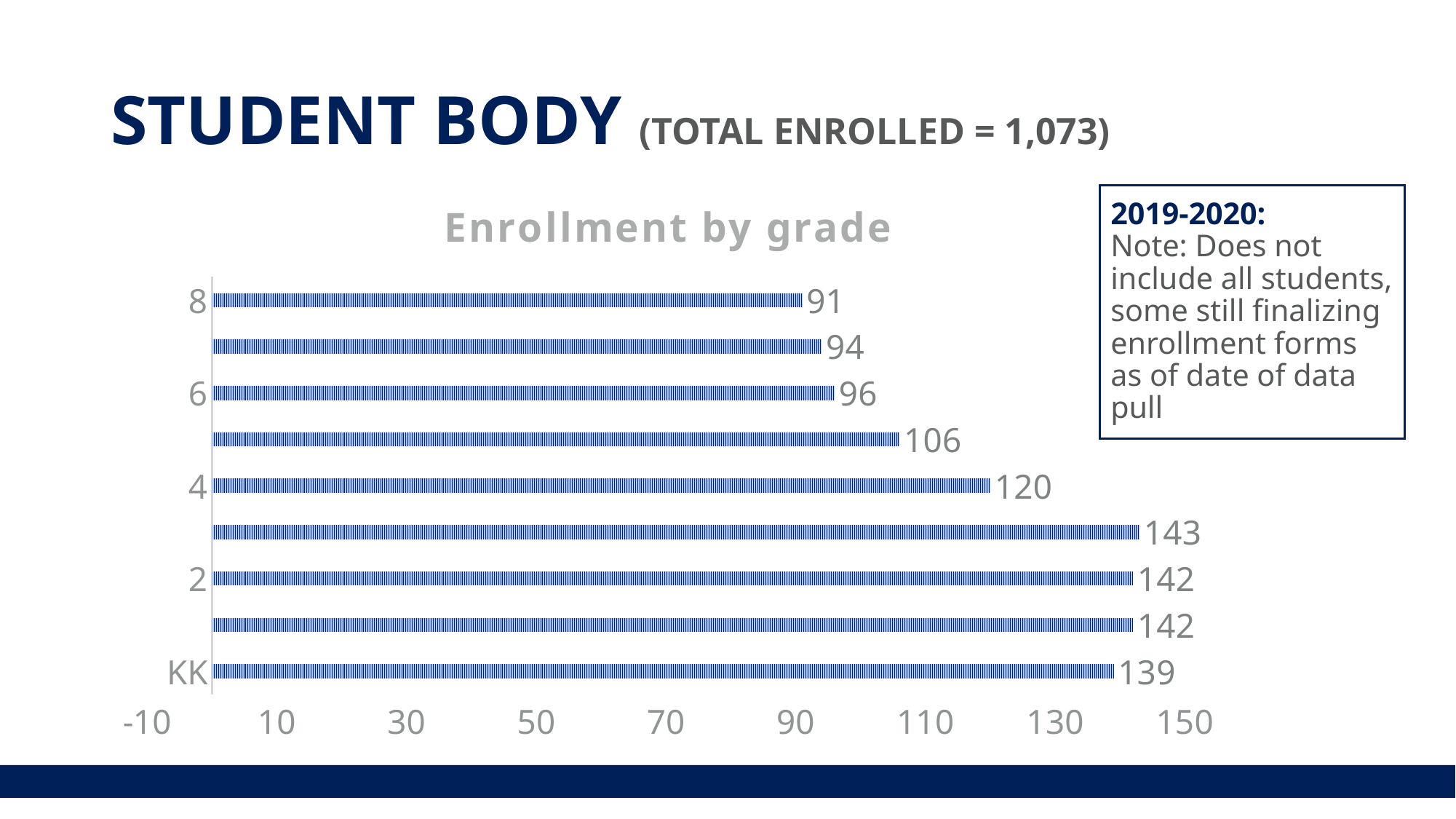
What is the difference between the enrollment for KK and grade 4? 19 What is the enrollment value for grade 2? 142 How many bars are shown in the chart? 9 What is the enrollment value for grade 6? 96 What is the enrollment value for KK? 139 Which has a larger enrollment, grade 4 or grade 6? grade 4 Which labeled grade has the lowest enrollment? 8 What is the title of the chart? Enrollment by grade What is the enrollment value for grade 8? 91 What kind of chart is shown on the slide? bar chart What is the difference between the enrollment for grade 2 and grade 8? 51 What is the enrollment value for grade 4? 120